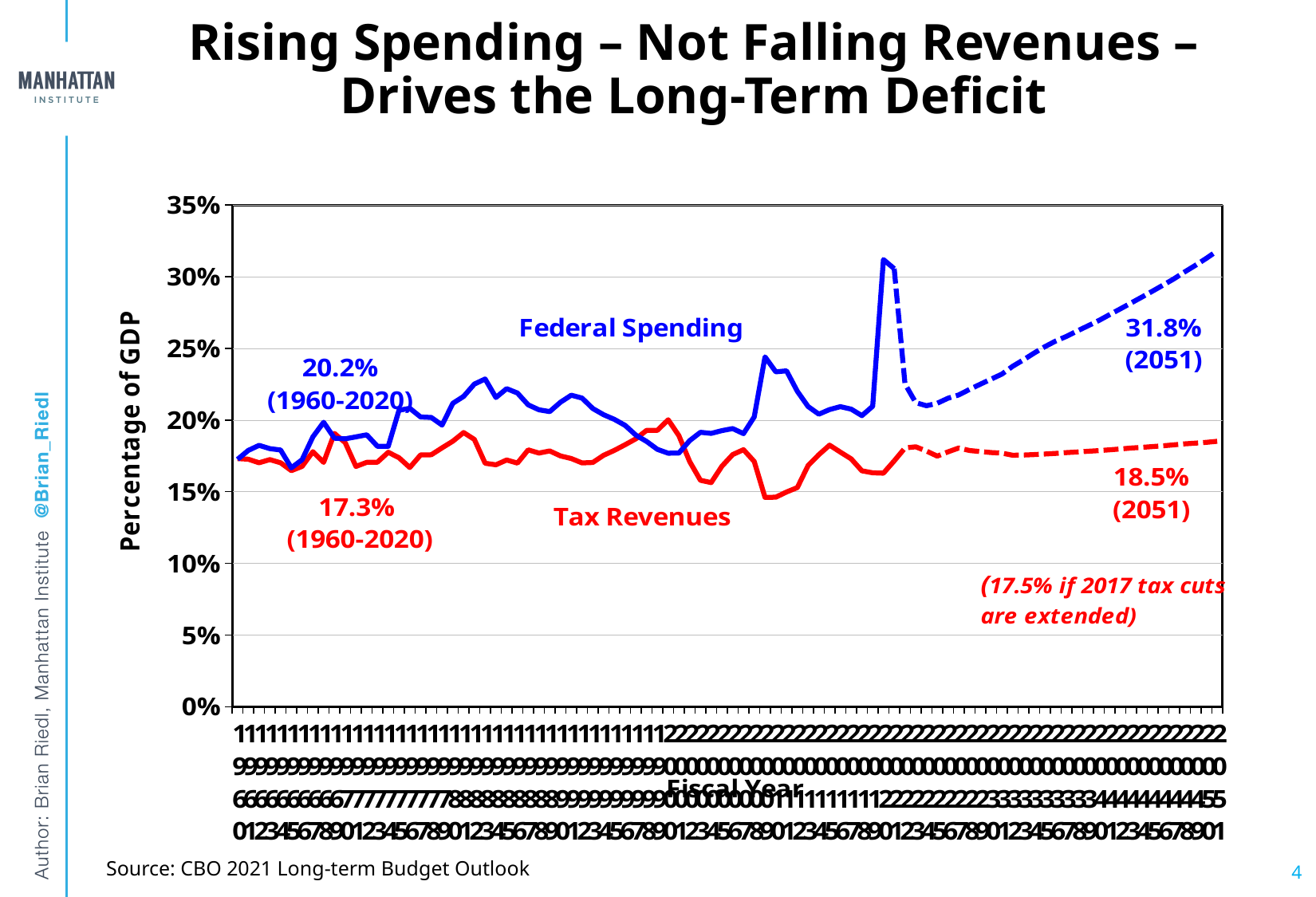
What kind of chart is shown on the slide? Line chart Which series is projected to be higher in 2051, Federal Spending or Tax Revenues? Federal Spending What is the projected value of Tax Revenues as a percentage of GDP in 2051? 18.5% What is the difference between the 1960-2020 averages for Federal Spending and Tax Revenues, in percentage points? 2.9 percentage points Is the peak value of Federal Spending around 2020 greater or less than 30%? greater What is the difference between the projected 2051 values for Federal Spending and Tax Revenues, in percentage points? 13.3 percentage points What was the average level of Tax Revenues as a percentage of GDP over 1960-2020, according to the chart annotation? 17.3% Does the dashed projection for Federal Spending rise or fall from the early 2020s to 2051? Rise How many data series are plotted on the chart? 2 What is the label on the vertical axis of the chart? Percentage of GDP What is the projected value of Federal Spending as a percentage of GDP in 2051? 31.8% What was the average level of Federal Spending as a percentage of GDP over 1960-2020, according to the chart annotation? 20.2%